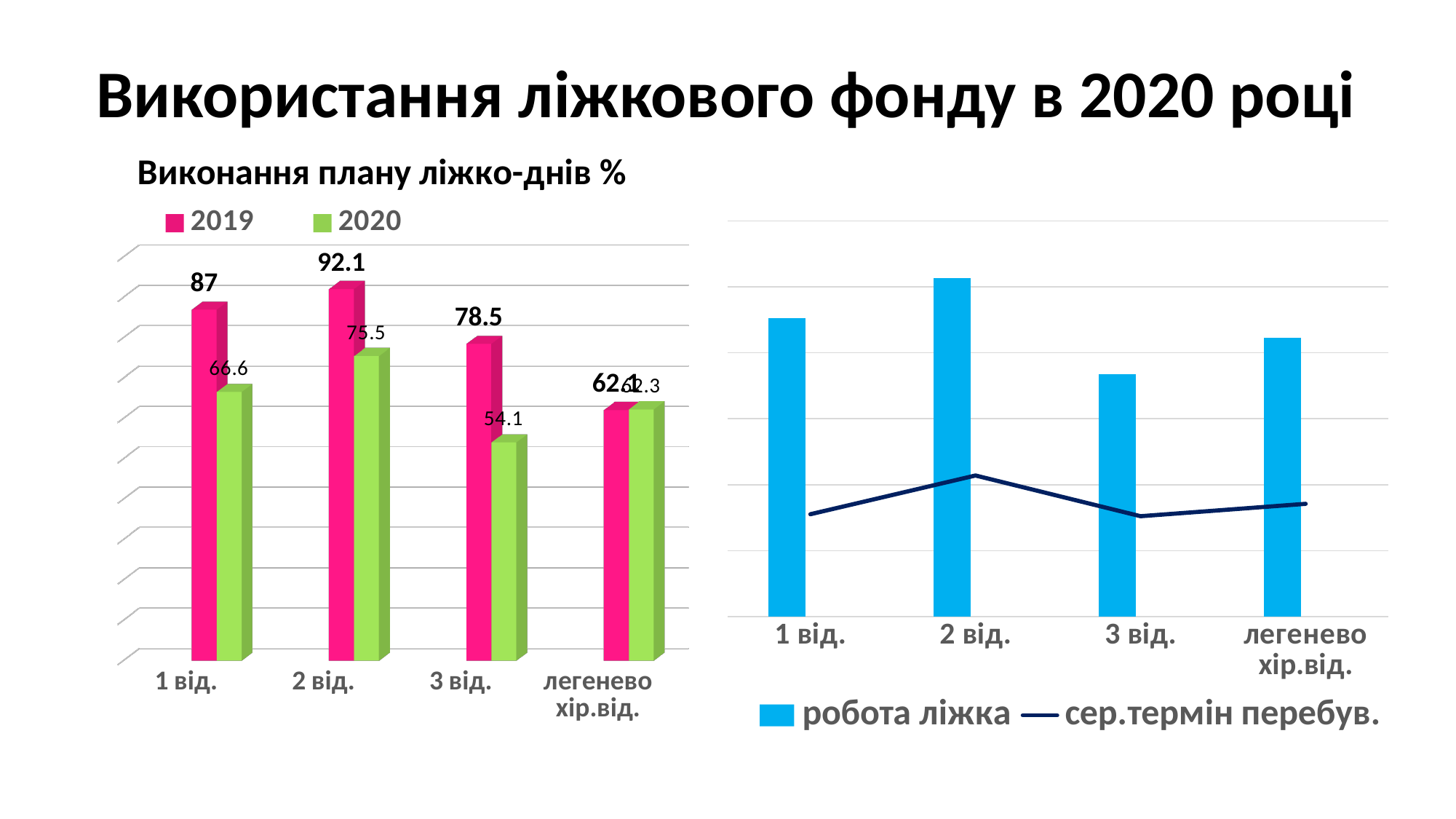
In the chart 'Виконання плану ліжко-днів %', what is the 2019 value for 1 від.? 87 In the chart 'Виконання плану ліжко-днів %', what is the 2020 value for 3 від.? 54.1 In the chart on the right, which category has the shortest 'робота ліжка' bar? 3 від. In the chart on the right, which category has the tallest 'робота ліжка' bar? 2 від. In the chart 'Виконання плану ліжко-днів %', what is the 2020 value for 2 від.? 75.5 In the chart 'Виконання плану ліжко-днів %', which category has the highest 2019 value? 2 від. In the chart 'Виконання плану ліжко-днів %', which category has the lowest 2020 value? 3 від. In the chart 'Виконання плану ліжко-днів %', what is the difference between the 2019 and 2020 values for 2 від.? 16.6 In the chart 'Виконання плану ліжко-днів %', what is the 2019 value for 3 від.? 78.5 In the chart on the right, how many categories are shown on the x axis? 4 In the chart 'Виконання плану ліжко-днів %', what is the difference between the 2019 and 2020 values for 1 від.? 20.4 In the chart 'Виконання плану ліжко-днів %', how many series does the legend list? 2